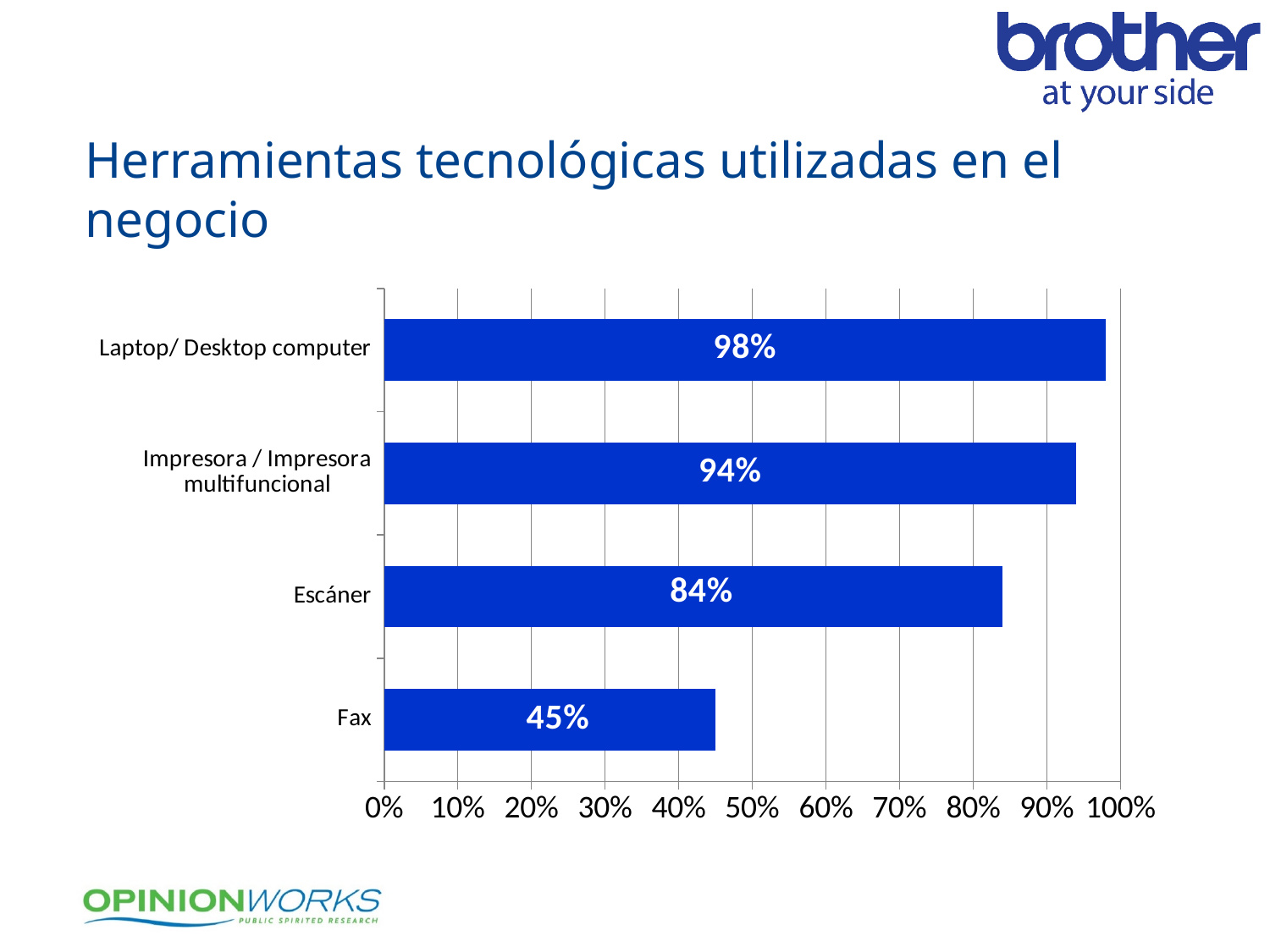
Which category has the highest value? Laptop/ Desktop computer Which category has the lowest value? Fax What is the difference between the values for Laptop/ Desktop computer and Fax? 53% What is the value for Laptop/ Desktop computer? 98% How many categories are shown in the chart? 4 What is the value for Impresora / Impresora multifuncional? 94% What kind of chart is shown on the slide? bar chart What is the value for Escáner? 84% Is the value for Fax greater or less than 50%? less Which is larger, the value for Escáner or the value for Fax? Escáner What is the value for Fax? 45% What is the difference between the values for Impresora / Impresora multifuncional and Escáner? 10%